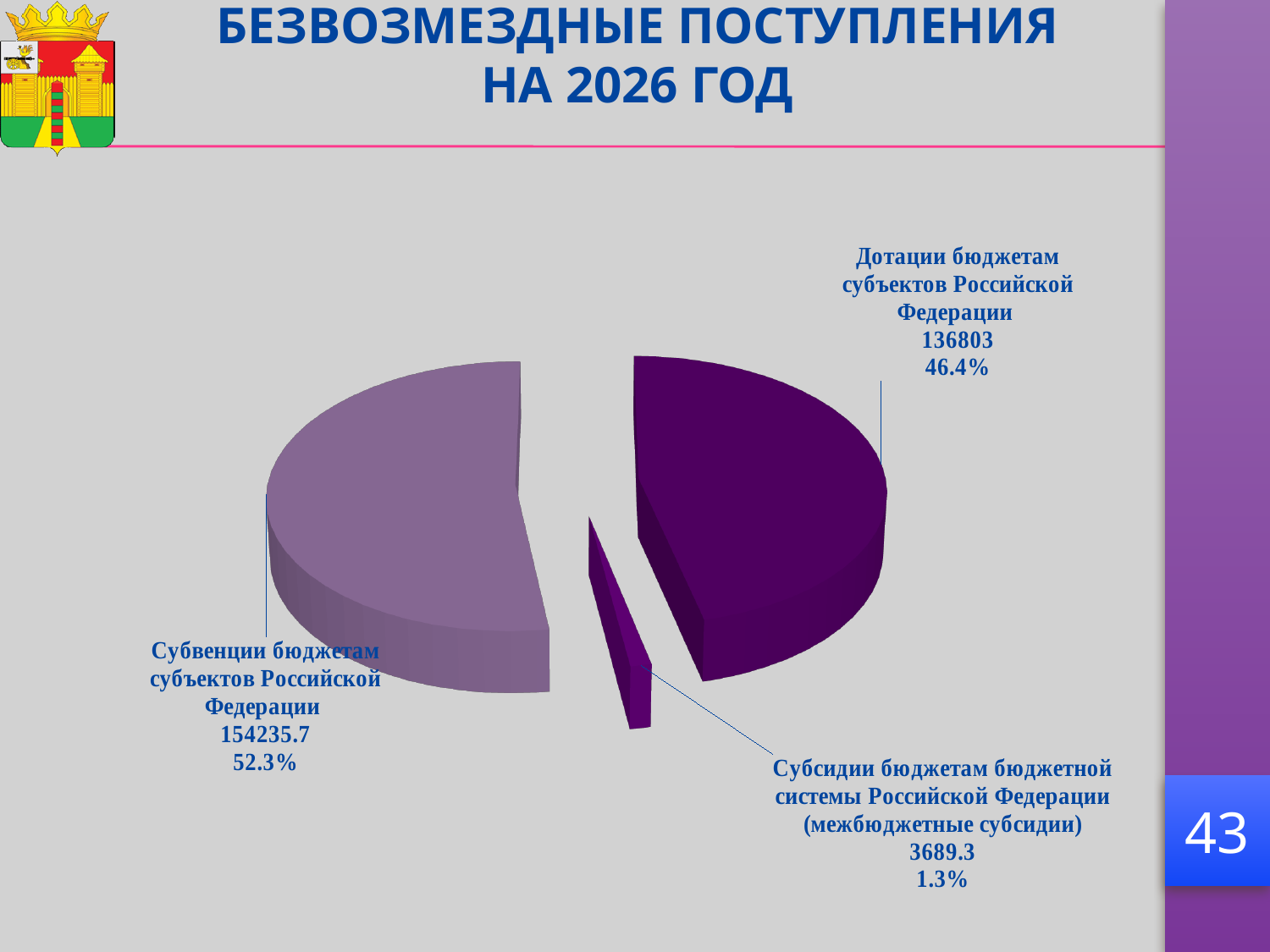
Which category has the largest slice of the pie? Субвенции бюджетам субъектов Российской Федерации Which category has the smallest slice of the pie? Субсидии бюджетам бюджетной системы Российской Федерации (межбюджетные субсидии) What is the value shown for Субвенции бюджетам субъектов Российской Федерации? 154235.7 What is the value shown for Субсидии бюджетам бюджетной системы Российской Федерации (межбюджетные субсидии)? 3689.3 Which is larger: Субвенции бюджетам субъектов Российской Федерации or Дотации бюджетам субъектов Российской Федерации? Субвенции бюджетам субъектов Российской Федерации What is the value shown for Дотации бюджетам субъектов Российской Федерации? 136803 What share of the pie does Дотации бюджетам субъектов Российской Федерации represent? 46.4% What is the difference between the values for Субвенции бюджетам субъектов Российской Федерации and Дотации бюджетам субъектов Российской Федерации? 17432.7 What kind of chart is shown on the slide? pie chart How many slices does the pie chart have? 3 What is the title of the slide containing the pie chart? БЕЗВОЗМЕЗДНЫЕ ПОСТУПЛЕНИЯ НА 2026 ГОД What share of the pie does Субсидии бюджетам бюджетной системы Российской Федерации (межбюджетные субсидии) represent? 1.3%